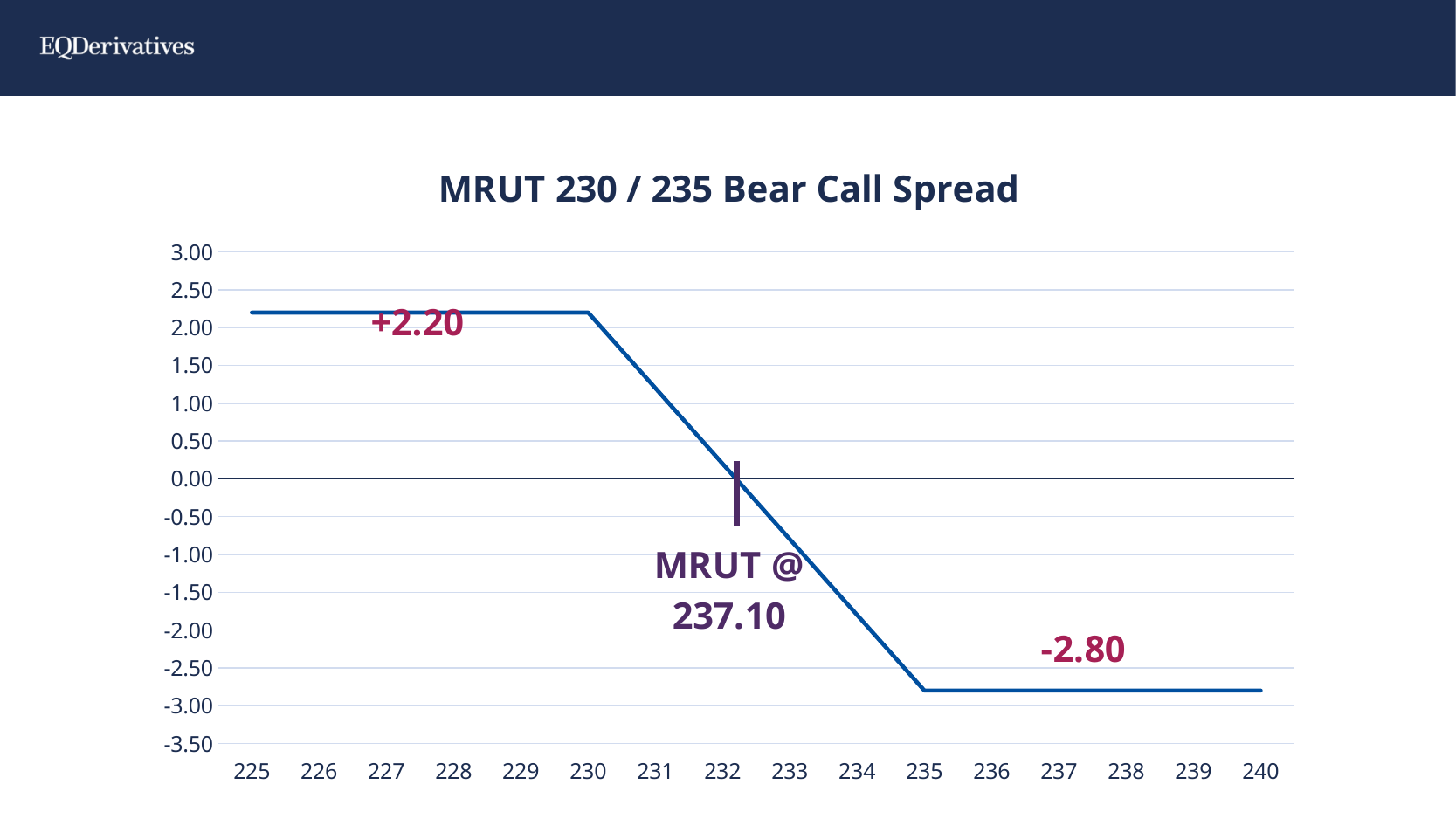
How many MRUT levels are labelled on the x axis? 16 Is the payoff value at an MRUT level of 231 greater or less than 0.50? greater What kind of chart is shown on the slide? line chart Is the payoff value at an MRUT level of 233 greater or less than 0.00? less What is the difference between the maximum payoff (+2.20) and the minimum payoff (-2.80)? 5.00 Which has the larger payoff value: MRUT at 227 or MRUT at 239? 227 What is the maximum value of the payoff line? +2.20 What is the payoff value at an MRUT level of 238? -2.80 Does the payoff line rise or fall as MRUT moves from 230 to 235? fall What is the minimum value of the payoff line? -2.80 What is the payoff value at an MRUT level of 228? +2.20 What is the title of the chart? MRUT 230 / 235 Bear Call Spread